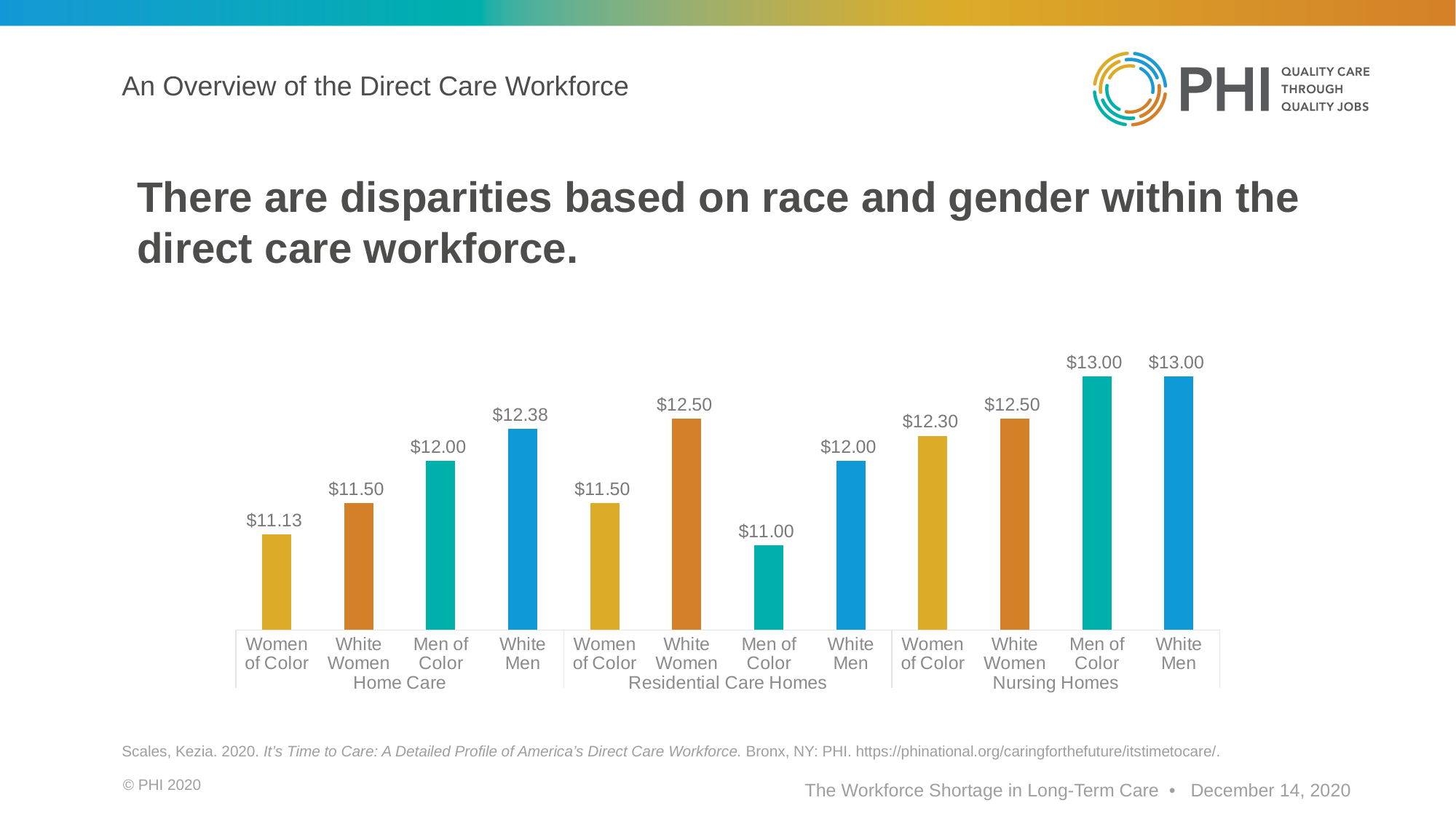
What is the value for Women of Color in Nursing Homes? $12.30 What is the difference between White Men and Women of Color in Home Care? $1.25 Which group has the lowest value in Home Care? Women of Color What is the value for White Men in Residential Care Homes? $12.00 What is the difference between White Women and Men of Color in Residential Care Homes? $1.50 What is the value for Men of Color in Residential Care Homes? $11.00 Which group has the highest value in Residential Care Homes? White Women How many bars are plotted on the chart? 12 What is the value for Women of Color in Home Care? $11.13 Which group has the lowest value across all three settings? Men of Color in Residential Care Homes What kind of chart is shown on the slide? Bar chart Which is larger: White Women in Home Care or White Women in Nursing Homes? White Women in Nursing Homes